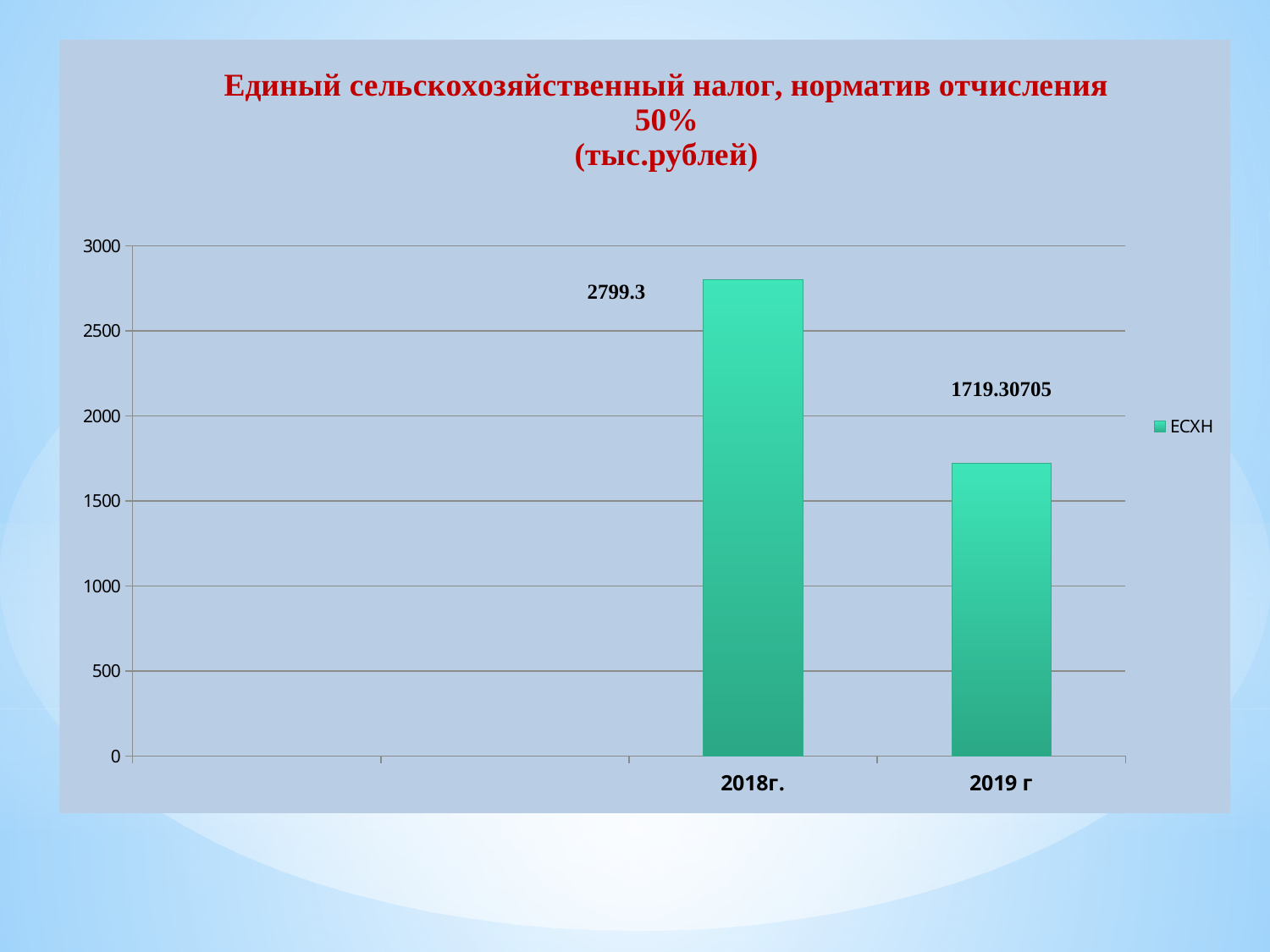
Is the value for 2018г. greater or less than 2500? greater What is the difference between the values for 2018г. and 2019 г? 1079.99295 What kind of chart is shown on the slide? bar chart How many series does the legend list? 1 Which year has the lowest value? 2019 г Is the value for 2019 г greater or less than 2000? less What is the value for 2019 г? 1719.30705 What is the value for 2018г.? 2799.3 Which is larger, the value for 2018г. or the value for 2019 г? 2018г. How many bars are plotted in the chart? 2 What series name is shown in the legend? ЕСХН Which year has the highest value? 2018г.